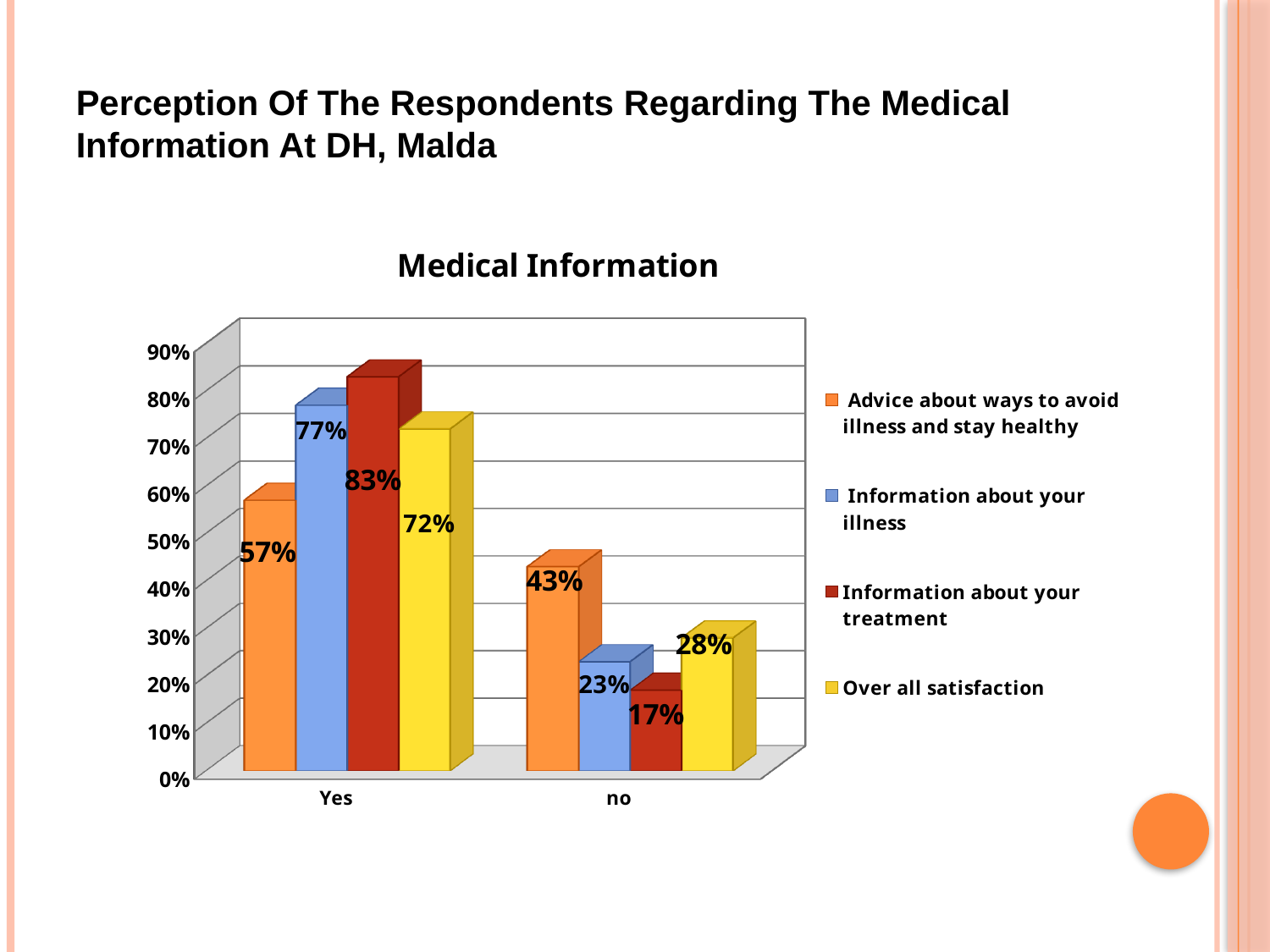
What kind of chart is shown? Bar chart Which series has the lowest value in the no category? Information about your treatment What is the value for "Information about your illness" in the no category? 23% What is the value for "Information about your treatment" in the Yes category? 83% What is the value for "Over all satisfaction" in the Yes category? 72% What is the difference between the Yes and no values for "Information about your illness"? 54% What is the value for "Advice about ways to avoid illness and stay healthy" in the no category? 43% What is the title of the chart? Medical Information How many series does the legend list? 4 Which is larger: the Yes value for "Advice about ways to avoid illness and stay healthy" or the Yes value for "Over all satisfaction"? Over all satisfaction How many categories are shown on the x axis? 2 Which series has the highest value in the Yes category? Information about your treatment